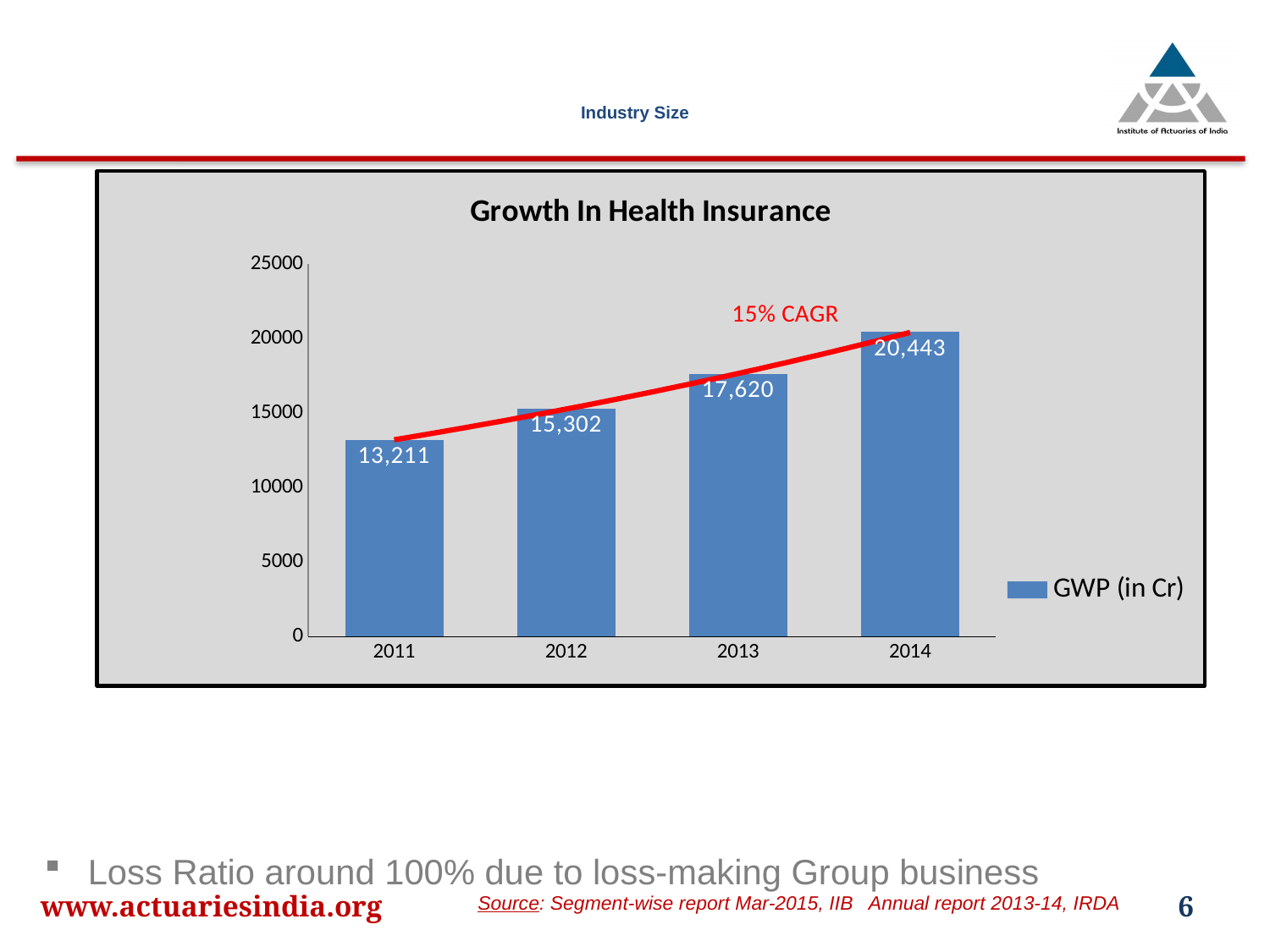
Do the GWP (in Cr) values rise or fall from 2011 to 2014? Rise What kind of chart is shown on the slide? Bar chart Which year has the highest GWP (in Cr)? 2014 What is the GWP (in Cr) value for 2014? 20,443 What is the difference in GWP (in Cr) between 2014 and 2011? 7,232 What is the GWP (in Cr) value for 2011? 13,211 What is the difference in GWP (in Cr) between 2012 and 2011? 2,091 Which year has the lowest GWP (in Cr)? 2011 Is the GWP (in Cr) value for 2014 greater or less than 20000? greater How many years are shown on the x axis of the chart? 4 What is the GWP (in Cr) value for 2013? 17,620 Which year has a larger GWP (in Cr), 2012 or 2013? 2013